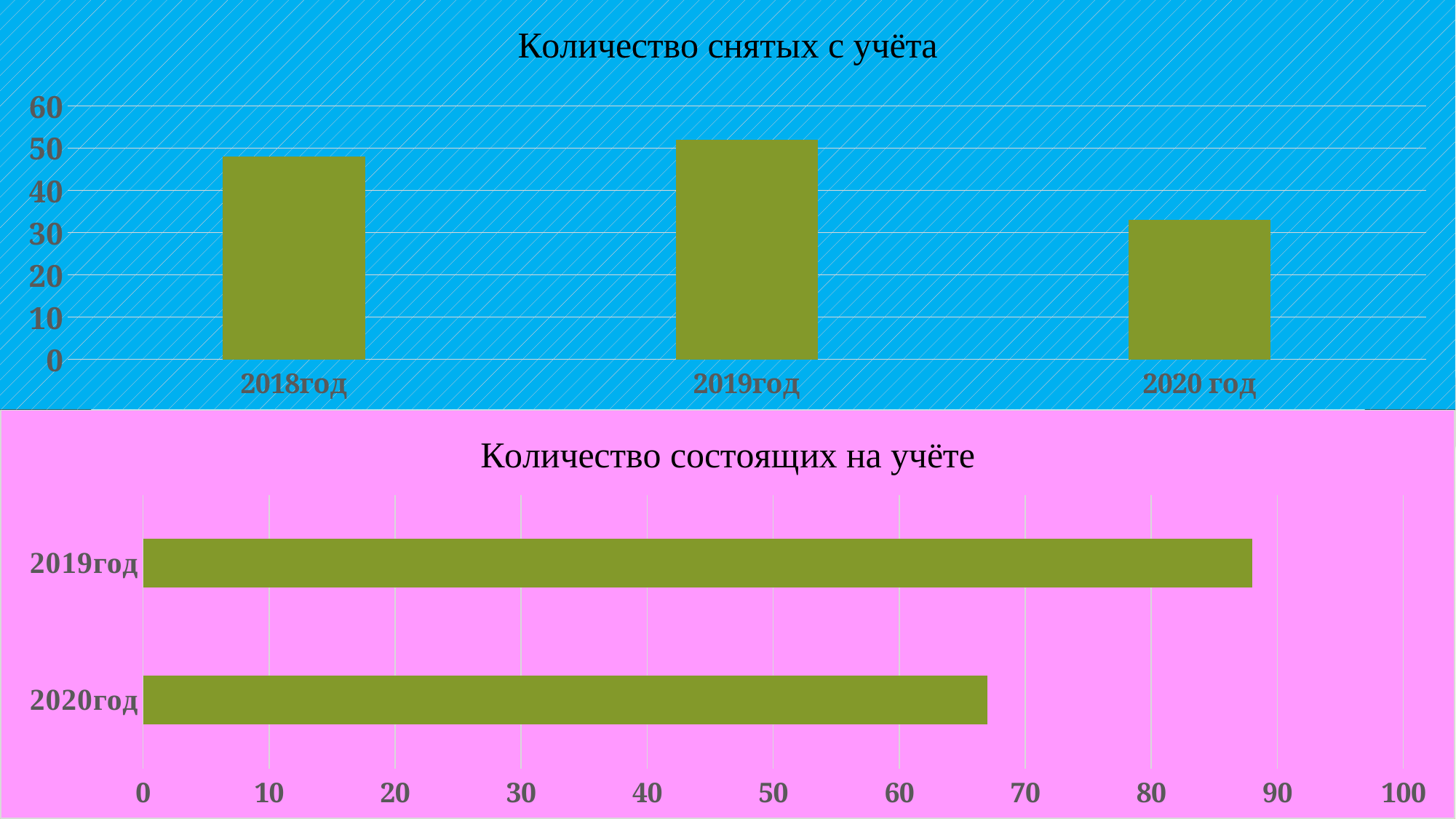
In the top chart "Количество снятых с учёта", how many categories are shown? 3 In the bottom chart "Количество состоящих на учёте", which year has the larger value, 2019год or 2020год? 2019год In the top chart "Количество снятых с учёта", which year has the lowest value? 2020 год In the top chart "Количество снятых с учёта", is the value for 2020 год greater or less than 40? less What kind of chart is the bottom chart titled "Количество состоящих на учёте"? bar chart What is the title of the top chart on the slide? Количество снятых с учёта In the top chart "Количество снятых с учёта", is the value for 2019год greater or less than 50? greater In the bottom chart "Количество состоящих на учёте", how many categories are shown? 2 What kind of chart is the top chart titled "Количество снятых с учёта"? bar chart In the bottom chart "Количество состоящих на учёте", is the value for 2020год greater or less than 60? greater In the top chart "Количество снятых с учёта", which year has the highest value? 2019год